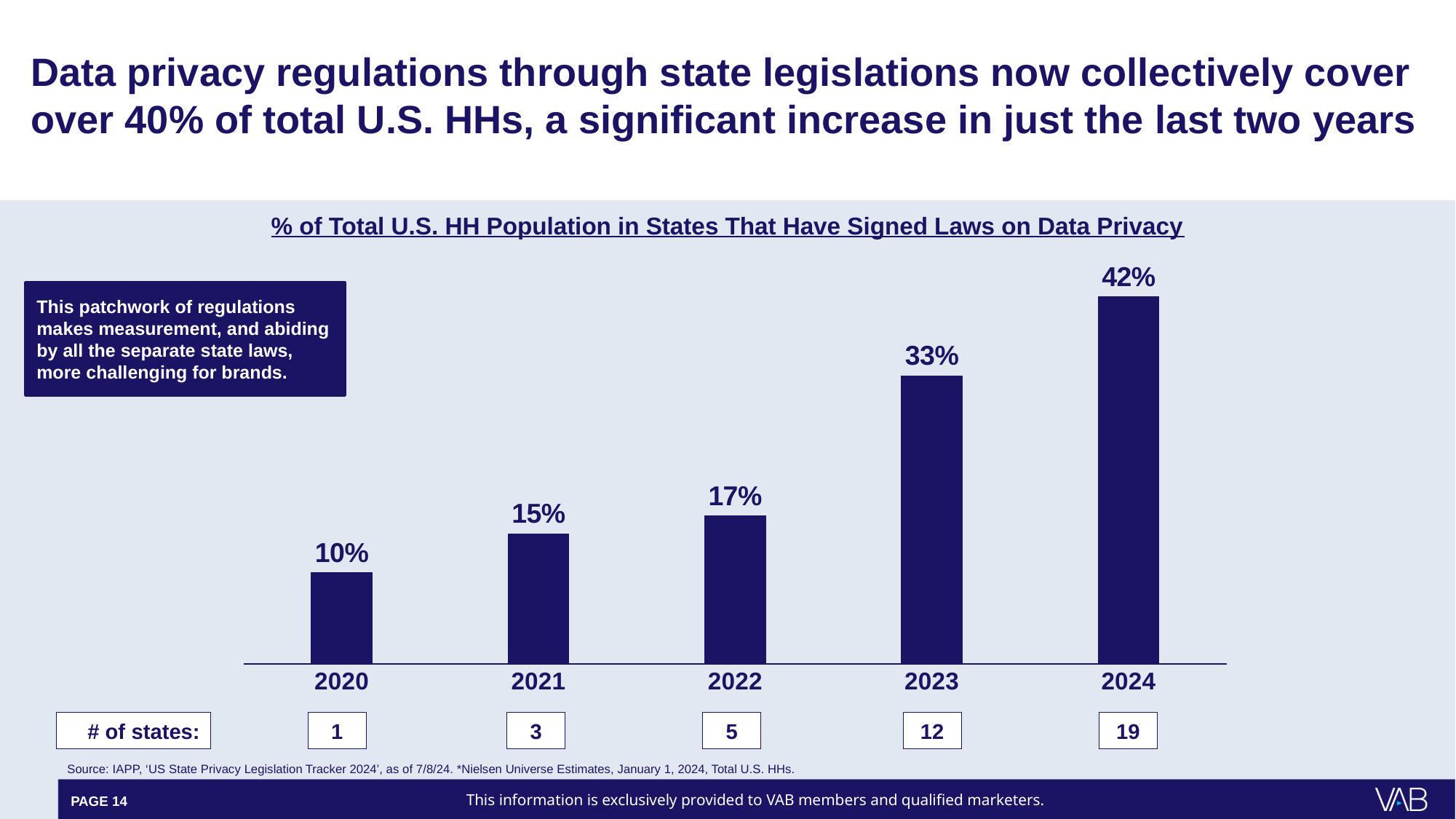
What is the value for 2022? 17% How many years are shown on the chart? 5 Which is larger, the value for 2022 or the value for 2023? 2023 Do the values rise or fall from 2020 to 2024? Rise What is the value for 2024? 42% What is the difference between the values for 2024 and 2023? 9% What is the title of the chart? % of Total U.S. HH Population in States That Have Signed Laws on Data Privacy What is the difference between the values for 2023 and 2020? 23% Which year has the highest value? 2024 Which year has the lowest value? 2020 What is the value for 2021? 15% What kind of chart is this? Bar chart